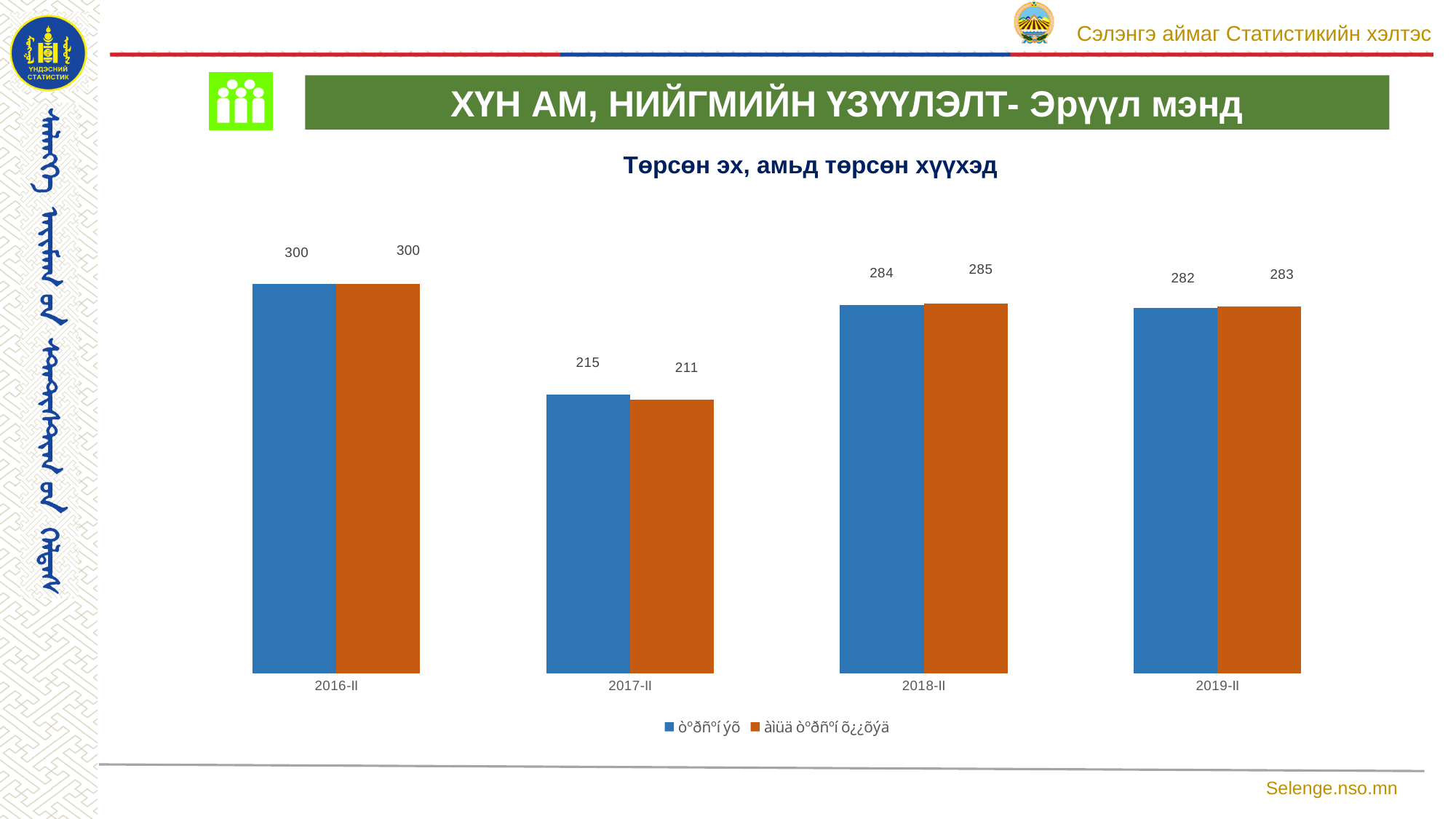
What is the title of the chart? Төрсөн эх, амьд төрсөн хүүхэд What kind of chart is shown on the slide? Bar chart What is the value of the blue bar for 2017-II? 215 What is the difference between the blue bar and the orange bar for 2017-II? 4 How many series does the legend list? 2 Which is larger: the blue bar for 2018-II or the blue bar for 2017-II? 2018-II How many categories are shown on the x axis? 4 Which category has the lowest value for the orange series? 2017-II Which category has the highest value for the blue series? 2016-II What is the value of the orange bar for 2019-II? 283 What is the difference between the blue bar values for 2016-II and 2017-II? 85 What is the value of the orange bar for 2018-II? 285